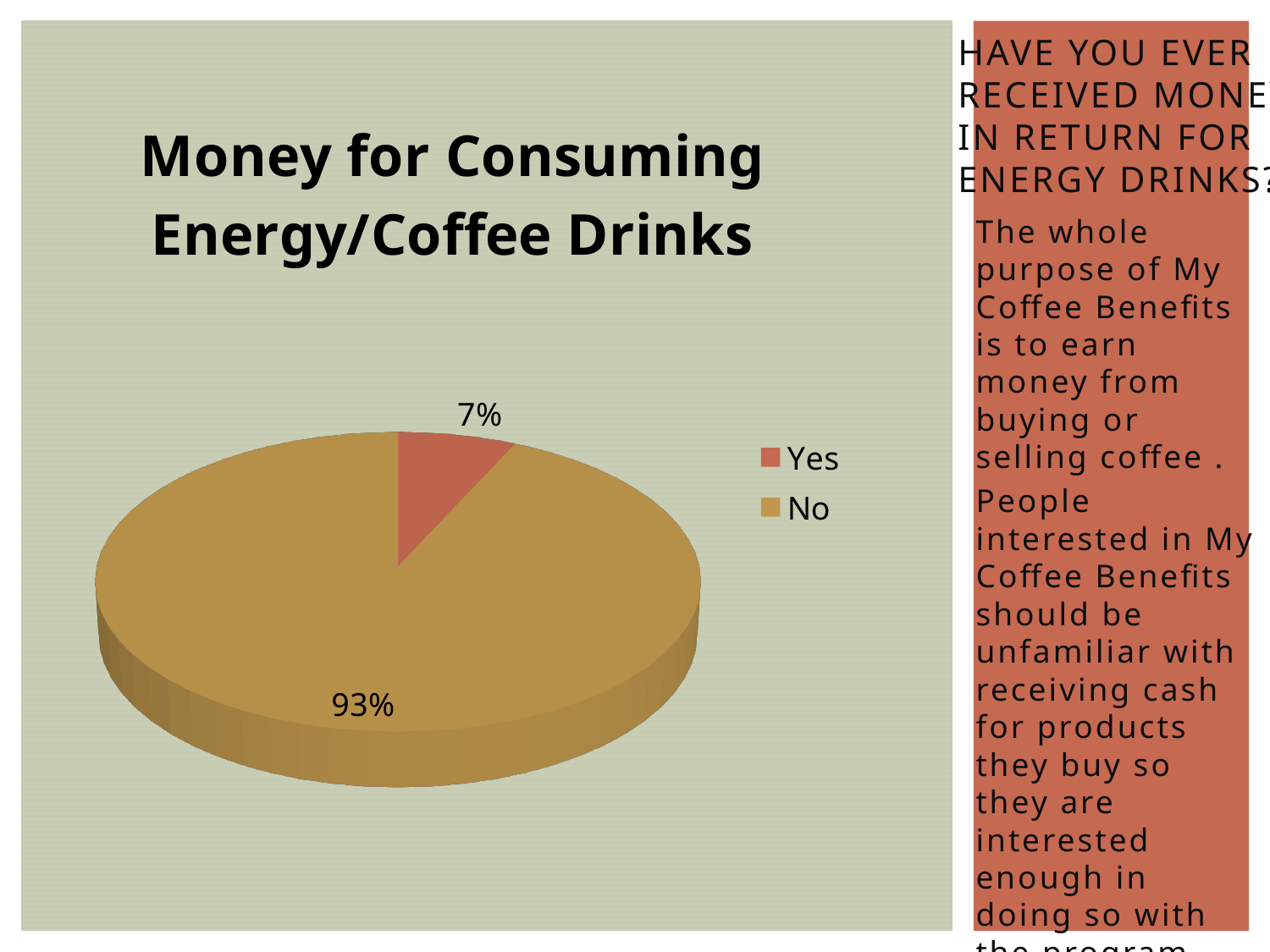
Which is larger, the "Yes" slice or the "No" slice? No What is the difference in percentage points between the "No" and "Yes" slices? 86 Which category has the largest share of the pie? No Which category has the smallest share of the pie? Yes How many entries does the legend list? 2 What kind of chart is shown on the slide? pie chart What share of the pie does the "No" slice represent? 93% What percentage of the pie is labelled "No"? 93% What percentage of the pie is labelled "Yes"? 7% What colour is the "Yes" slice in the pie chart? red What is the title of the chart? Money for Consuming Energy/Coffee Drinks How many slices does the pie chart have? 2